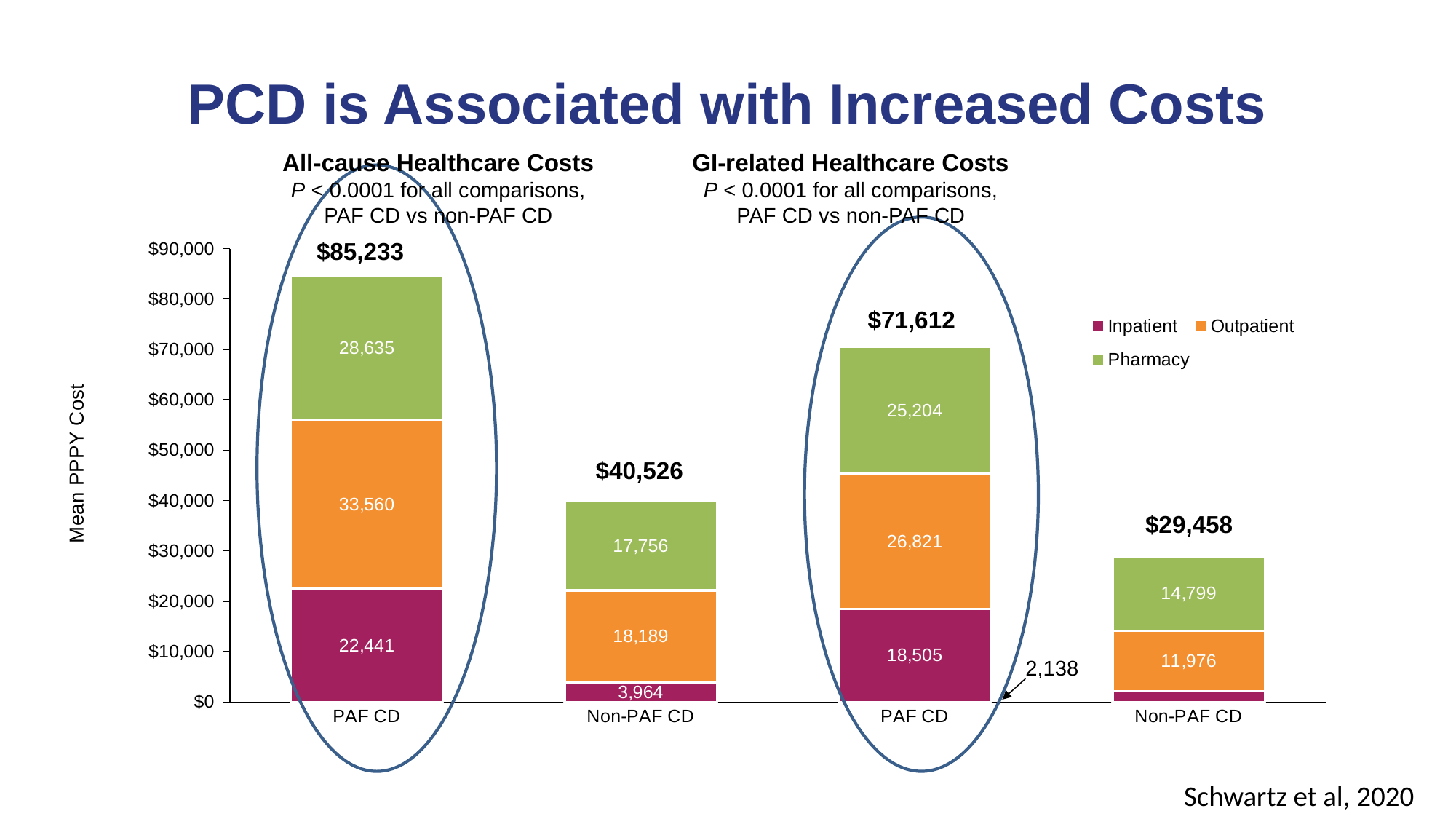
What is the total mean PPPY cost for PAF CD under GI-related Healthcare Costs? $71,612 Which bar has the lowest total cost? Non-PAF CD (GI-related Healthcare Costs) How many series does the legend list? 3 What is the Pharmacy cost for PAF CD under GI-related Healthcare Costs? 25,204 What is the total mean PPPY cost for Non-PAF CD under All-cause Healthcare Costs? $40,526 What is the difference in Inpatient cost between PAF CD and Non-PAF CD under All-cause Healthcare Costs? 18,477 Which bar has the highest total cost? PAF CD (All-cause Healthcare Costs) Is the total cost for Non-PAF CD under GI-related Healthcare Costs greater or less than $30,000? less Under GI-related Healthcare Costs, which is larger: the Pharmacy cost for PAF CD or the Outpatient cost for PAF CD? Outpatient cost for PAF CD What is the Outpatient cost for PAF CD under All-cause Healthcare Costs? 33,560 What is the Inpatient cost for Non-PAF CD under GI-related Healthcare Costs? 2,138 What kind of chart is shown on the slide? Stacked bar chart